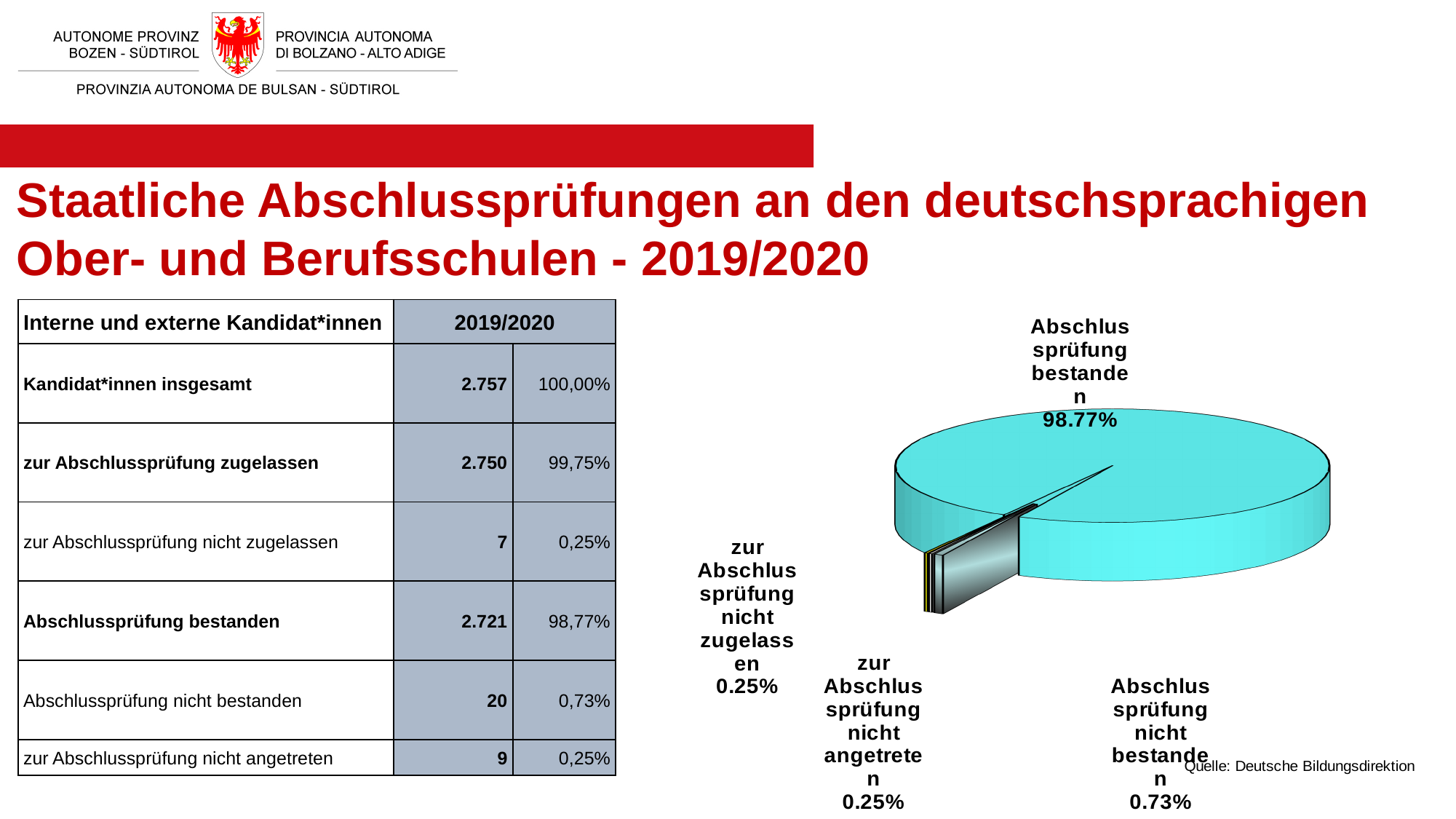
What share of the pie chart is labelled "Abschlussprüfung nicht bestanden"? 0.73% Which slice of the pie chart is the largest? Abschlussprüfung bestanden Which is larger in the pie chart: "Abschlussprüfung nicht bestanden" or "zur Abschlussprüfung nicht zugelassen"? Abschlussprüfung nicht bestanden How many slices does the pie chart have? 4 What share of the pie chart is labelled "zur Abschlussprüfung nicht angetreten"? 0.25% What share of the pie chart is labelled "Abschlussprüfung bestanden"? 98.77% What is the difference in percentage points between the "Abschlussprüfung nicht bestanden" slice and the "zur Abschlussprüfung nicht angetreten" slice in the pie chart? 0.48 What colour is the largest slice of the pie chart? light blue (cyan) What is the difference in percentage points between the "Abschlussprüfung bestanden" slice and the "Abschlussprüfung nicht bestanden" slice in the pie chart? 98.04 Is the pie chart drawn in 3D? yes What share of the pie chart is labelled "zur Abschlussprüfung nicht zugelassen"? 0.25% What kind of chart is shown on the slide? pie chart